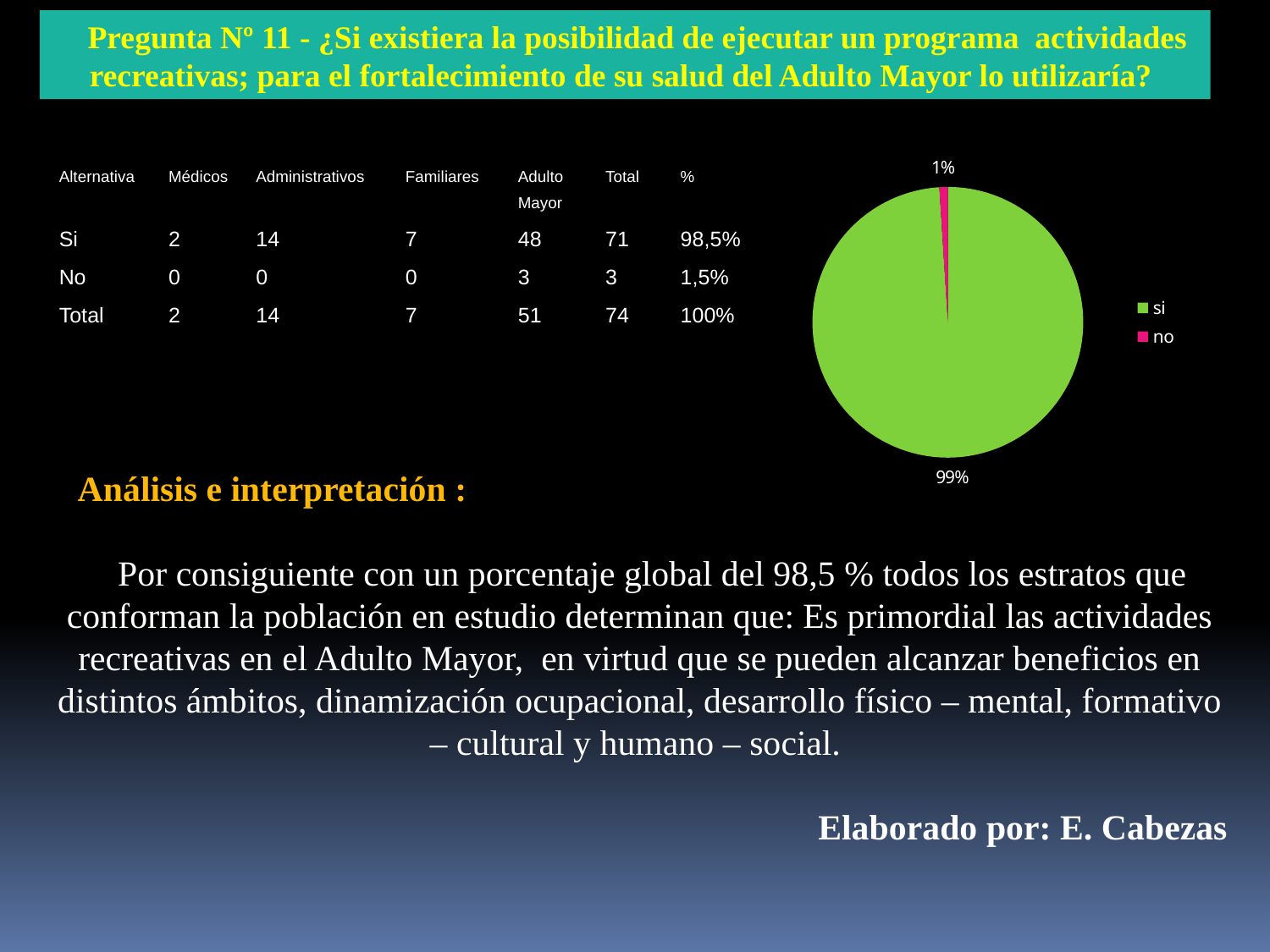
How many entries does the pie chart's legend list? 2 What are the two entries listed in the pie chart's legend? si, no Which slice of the pie chart is the largest? si Which slice of the pie chart is the smallest? no What share of the pie does the "si" slice represent? 99% What is the difference in percentage points between the "si" and "no" slices of the pie chart? 98 What colour is the "si" slice in the pie chart? green What percentage does the "no" slice of the pie chart show? 1% Which is larger in the pie chart, the "si" slice or the "no" slice? si What kind of chart is shown on the slide? pie chart What percentage does the "si" slice of the pie chart show? 99% How many slices does the pie chart have? 2